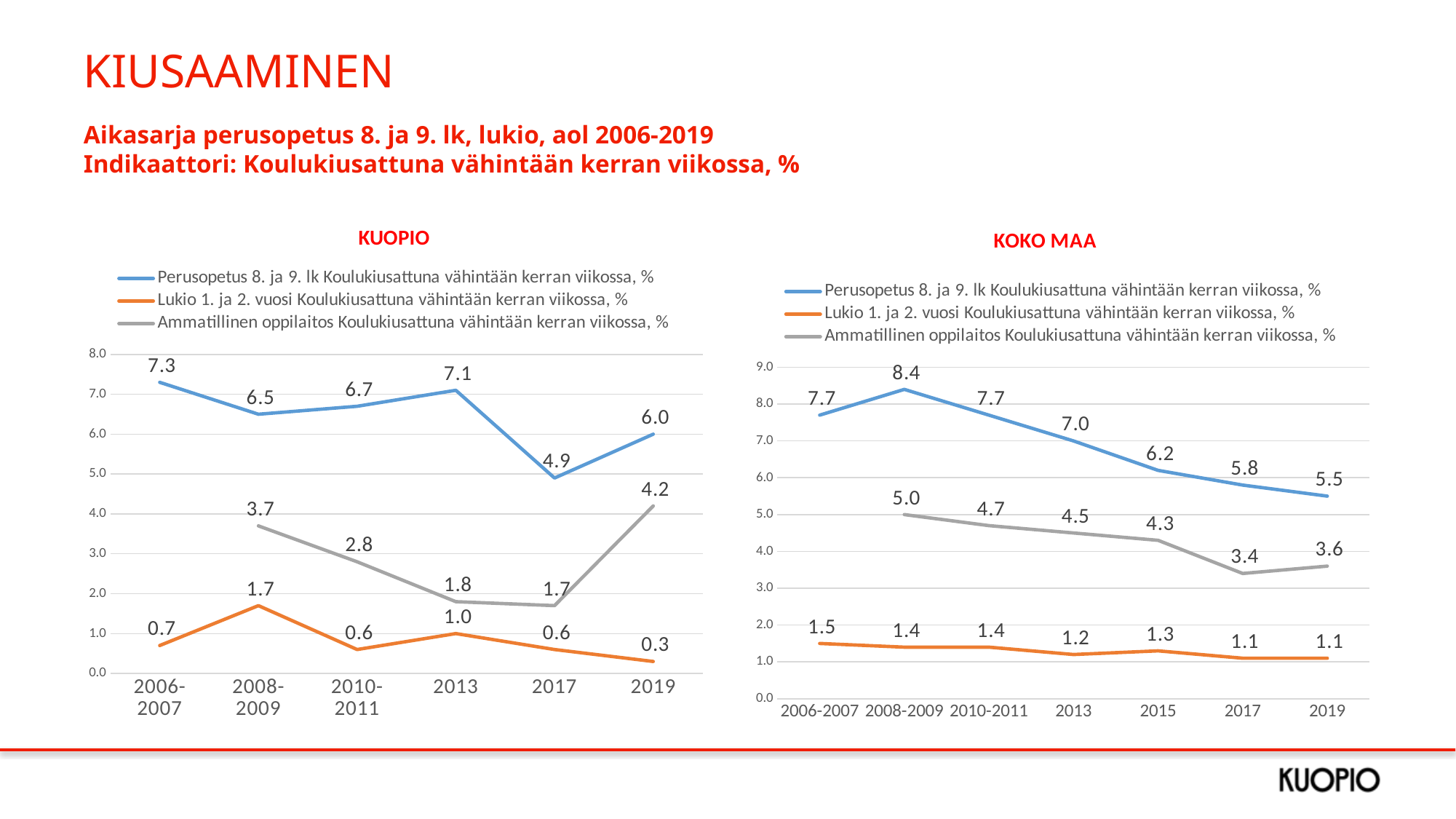
What type of chart is the KUOPIO chart? Line chart In the KUOPIO chart, what is the difference between the Perusopetus 8. ja 9. lk value in 2006-2007 and in 2017? 2.4 In the KUOPIO chart, what is the value for Perusopetus 8. ja 9. lk in 2013? 7.1 In the KOKO MAA chart, how many x-axis categories are shown? 7 In the KOKO MAA chart, what is the value for Perusopetus 8. ja 9. lk in 2008-2009? 8.4 In the KOKO MAA chart, does the Perusopetus 8. ja 9. lk series rise or fall from 2008-2009 to 2019? fall In the KUOPIO chart, what is the value for Lukio 1. ja 2. vuosi in 2019? 0.3 Which is larger: the Ammatillinen oppilaitos value in 2019 in the KUOPIO chart or in the KOKO MAA chart? KUOPIO (4.2) In the KUOPIO chart, in which year is the Perusopetus 8. ja 9. lk value lowest? 2017 How many series does the legend of the KOKO MAA chart list? 3 In the KUOPIO chart, in which year does the Ammatillinen oppilaitos series reach its highest value? 2019 In the KOKO MAA chart, what is the value for Ammatillinen oppilaitos in 2017? 3.4